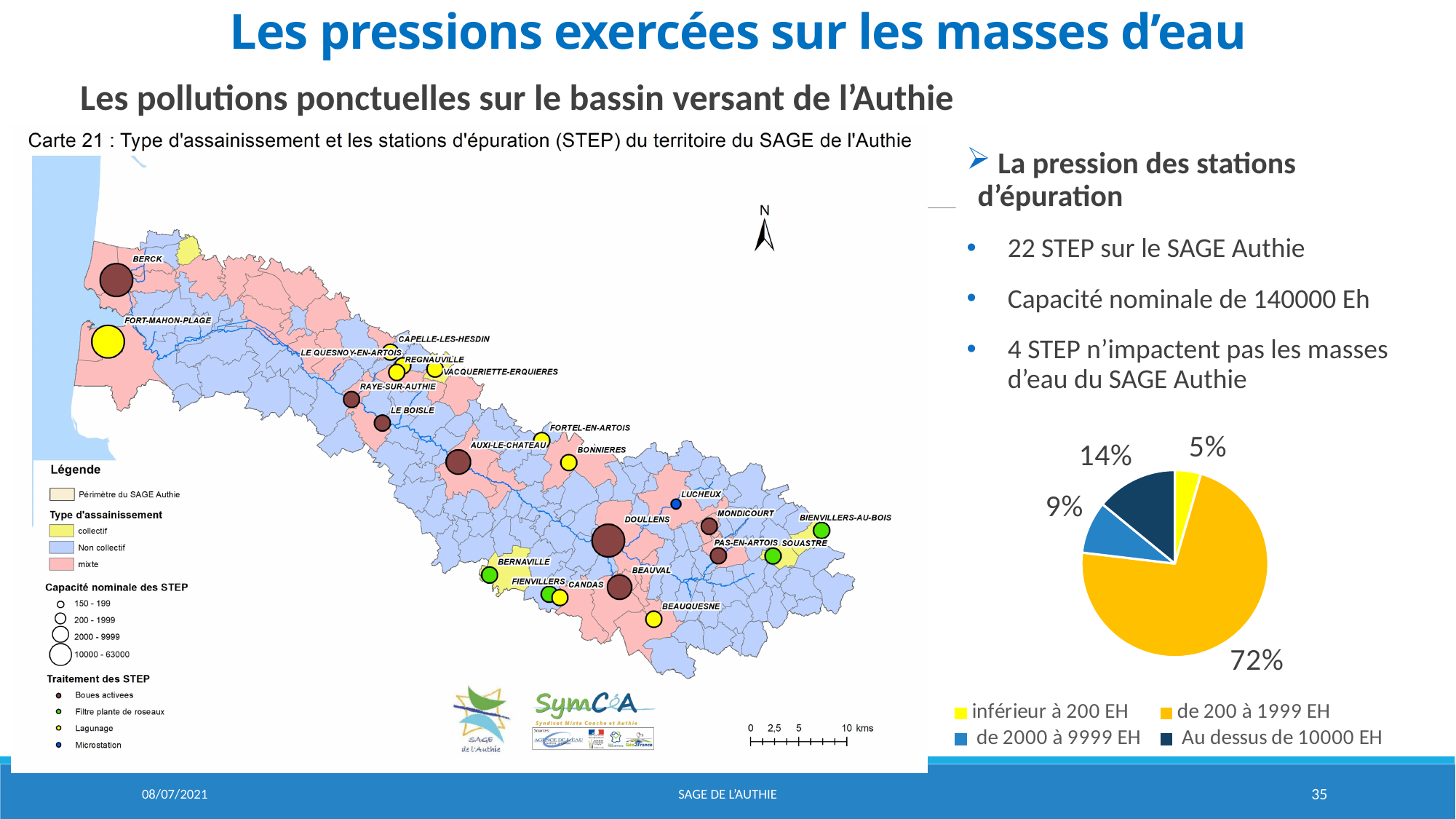
In the pie chart, which is larger: the share for 'Au dessus de 10000 EH' or the share for 'inférieur à 200 EH'? Au dessus de 10000 EH In the pie chart, what share is shown for the category 'inférieur à 200 EH'? 5% In the pie chart, what share is shown for the category 'Au dessus de 10000 EH'? 14% How many categories does the pie chart legend list? 4 What kind of chart is shown on the right side of the slide? pie chart Which category has the largest slice in the pie chart? de 200 à 1999 EH Which category has the smallest slice in the pie chart? inférieur à 200 EH In the pie chart, what share is shown for the category 'de 200 à 1999 EH'? 72% In the pie chart, what is the combined share of 'de 2000 à 9999 EH' and 'Au dessus de 10000 EH'? 23% In the pie chart, what share is shown for the category 'de 2000 à 9999 EH'? 9% In the pie chart, what is the difference between the shares for 'Au dessus de 10000 EH' and 'de 2000 à 9999 EH'? 5% What colour is the slice for 'de 200 à 1999 EH' in the pie chart? orange